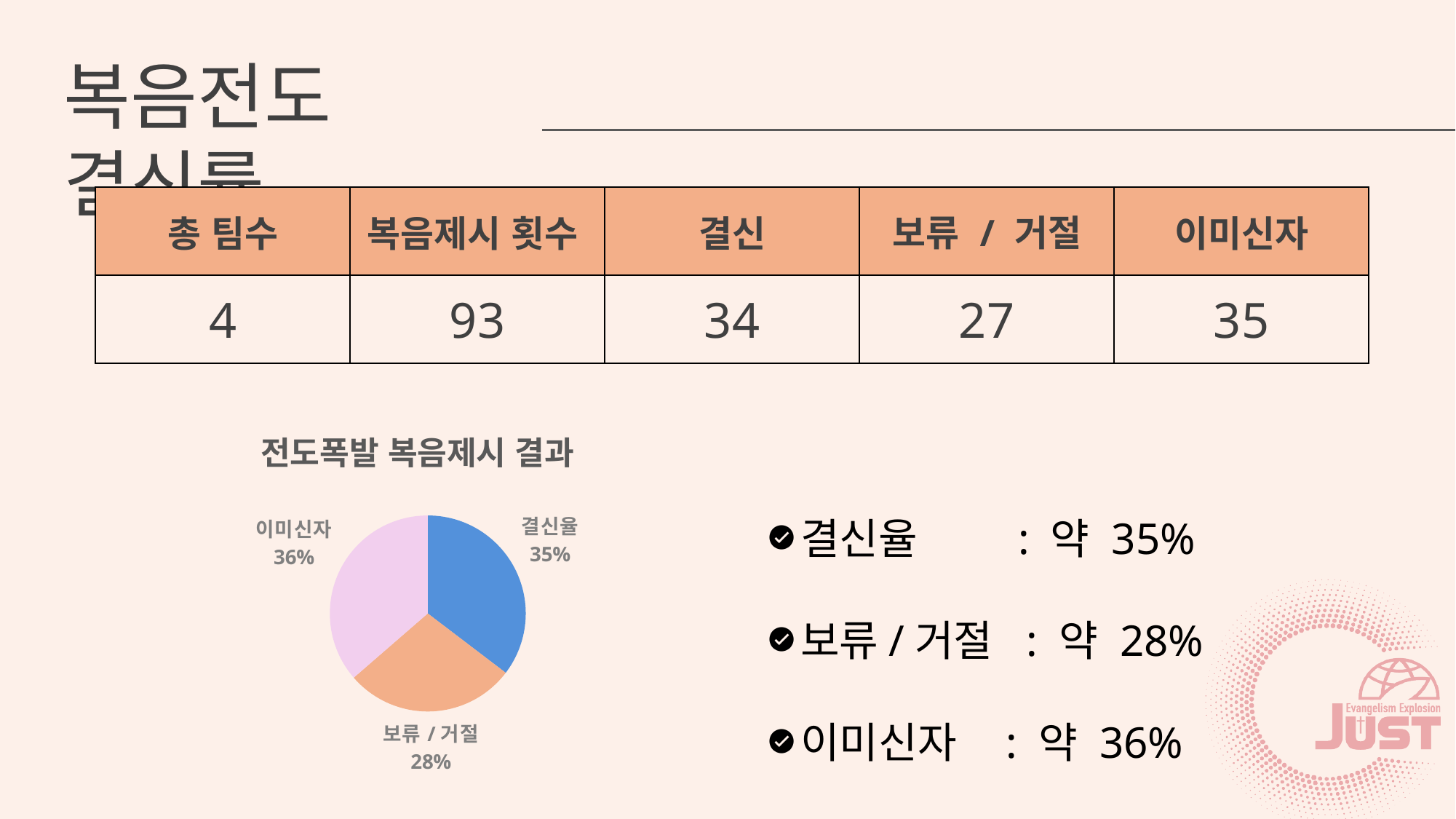
What colour is the 결신율 slice in the pie chart? blue Which is larger in the pie chart, 결신율 or 보류 / 거절? 결신율 What share of the pie does the 이미신자 slice represent? 36% What is the value shown for 이미신자 in the pie chart? 36% What kind of chart is shown on the slide? pie chart What is the title of the pie chart? 전도폭발 복음제시 결과 What is the difference between the 이미신자 and 보류 / 거절 slices in the pie chart? 8% What is the value shown for 보류 / 거절 in the pie chart? 28% How many slices does the pie chart have? 3 What is the value shown for 결신율 in the pie chart? 35% Which slice of the pie chart is the smallest? 보류 / 거절 What is the difference between the 결신율 and 보류 / 거절 slices in the pie chart? 7%